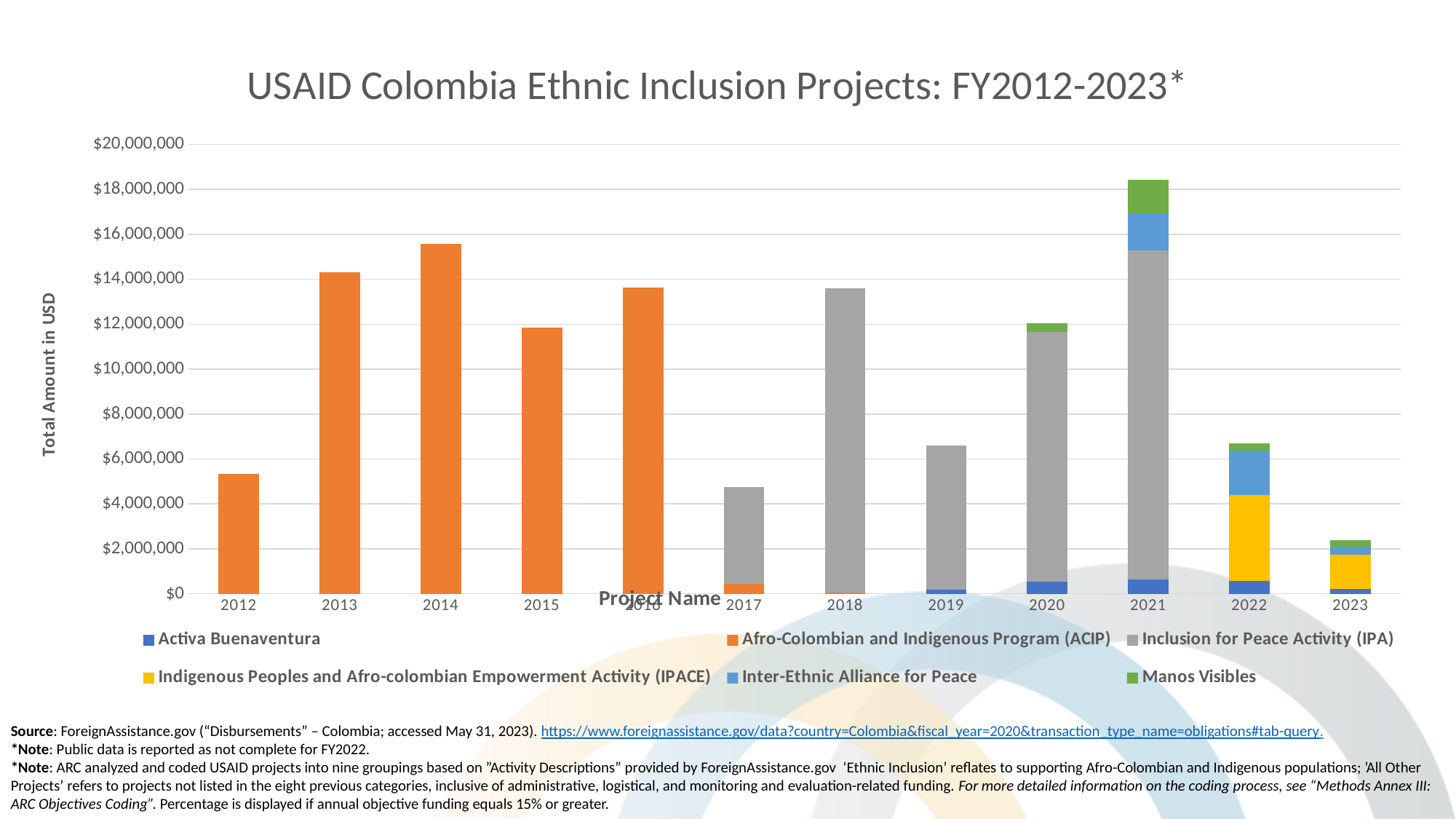
Is the total for 2014 greater or less than $14,000,000? greater What is the title of the chart? USAID Colombia Ethnic Inclusion Projects: FY2012-2023* Which year has the lowest total bar? 2023 Which year has the larger total, 2013 or 2014? 2014 How many fiscal years are shown on the x axis? 12 Which year has the highest total bar? 2021 Is the total for 2012 greater or less than $6,000,000? less What is the label of the y axis? Total Amount in USD How many series does the legend list? 6 Do the totals rise or fall from 2021 to 2023? fall What kind of chart is shown on the slide? Stacked bar chart Which year has the larger total, 2012 or 2017? 2012